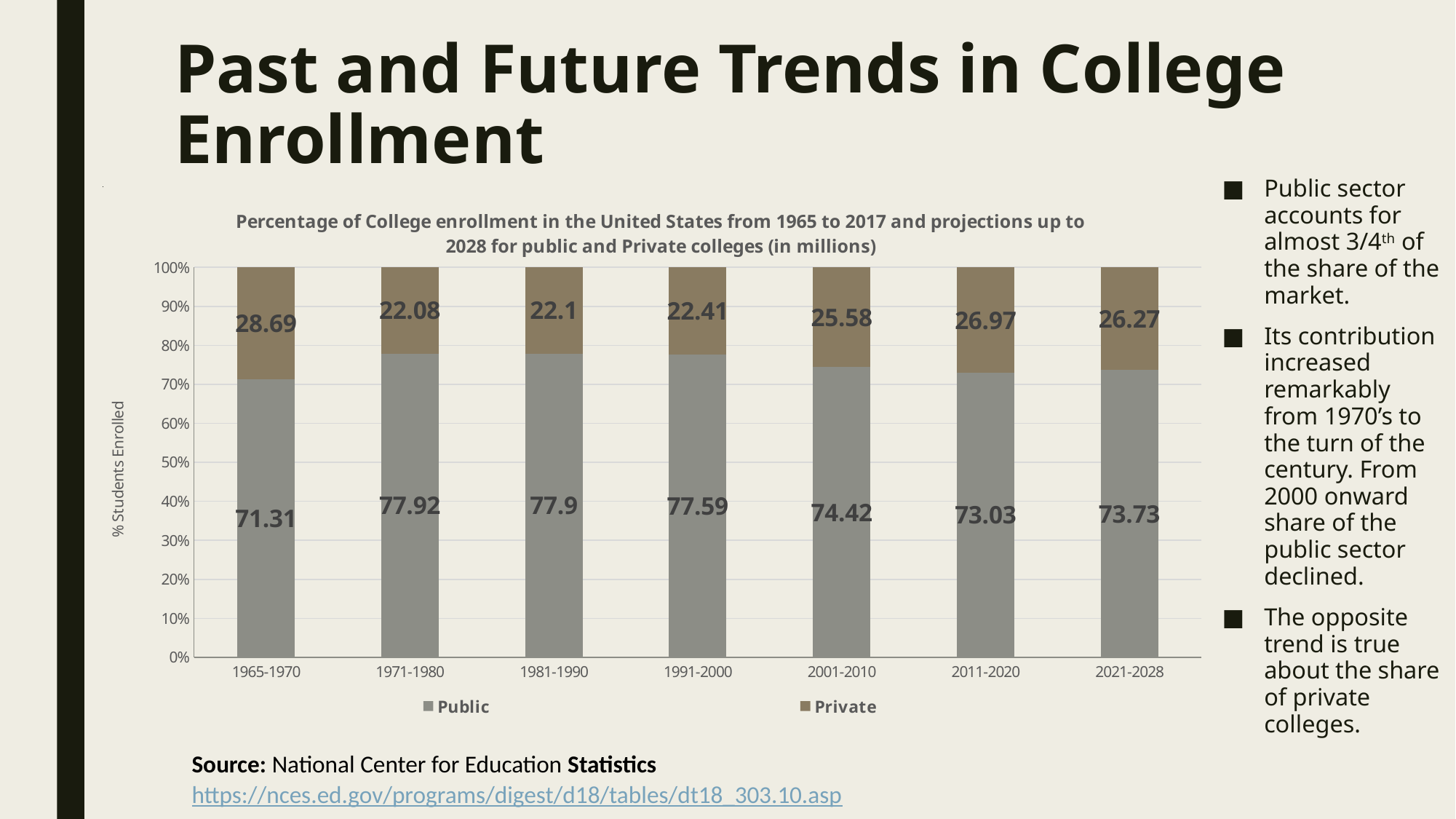
Which period has the highest Public value? 1971-1980 Which period has the highest Private value? 1965-1970 Is the Private value larger for 2001-2010 or for 1991-2000? 2001-2010 What kind of chart is shown on the slide? Stacked bar chart How many series does the legend list? 2 What is the Public value for 2021-2028? 73.73 How many periods are shown on the x axis? 7 What is the difference between the Public values for 1971-1980 and 1965-1970? 6.61 What is the label of the y axis? % Students Enrolled What is the Private value for 2011-2020? 26.97 What is the Public value for 1965-1970? 71.31 Which period has the lowest Private value? 1971-1980